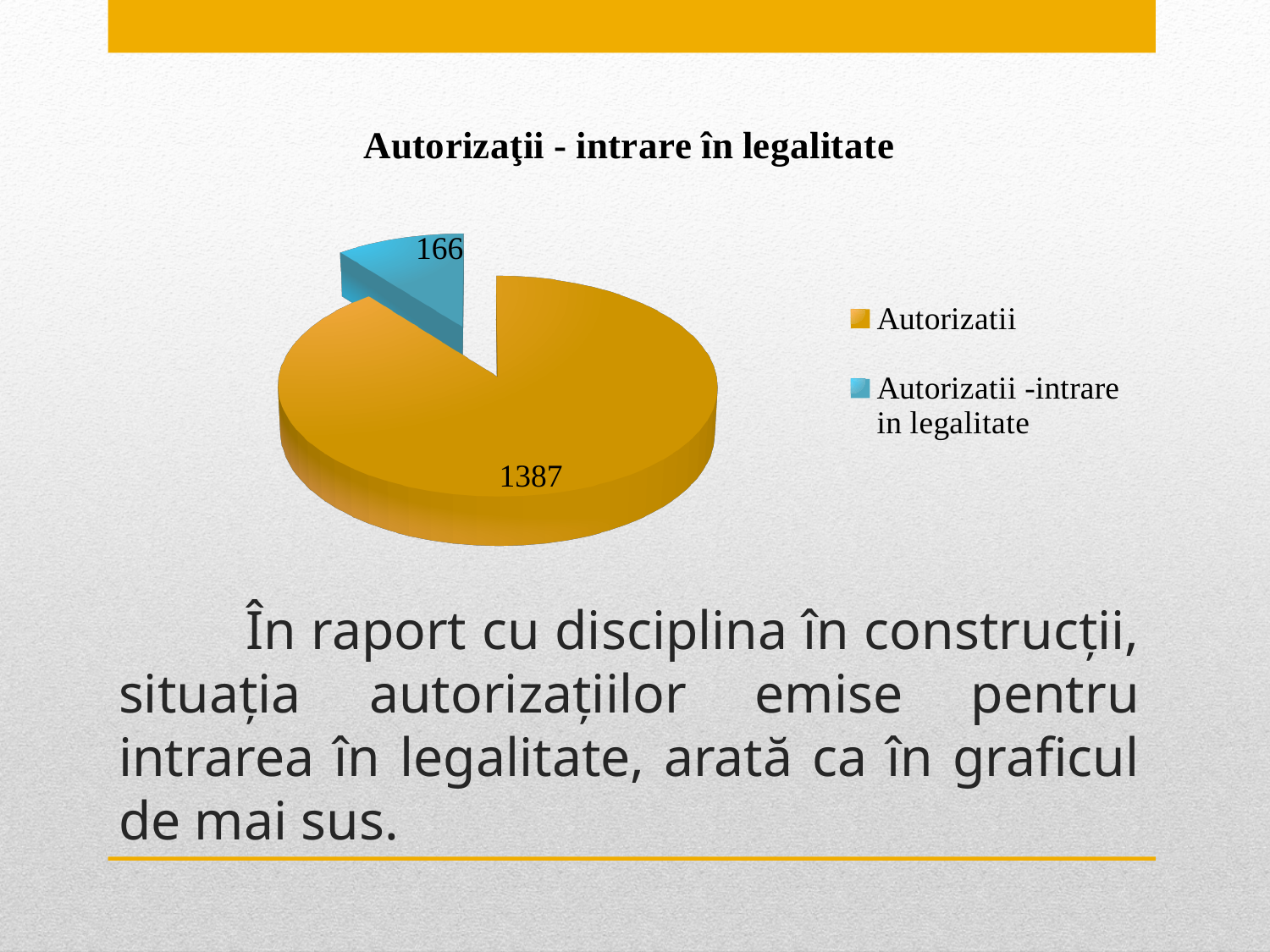
What is the total of the two slices in the pie chart? 1553 What colour is the Autorizatii -intrare in legalitate slice? blue Which slice is the largest in the pie chart? Autorizatii What is the value for the Autorizatii -intrare in legalitate slice? 166 What type of chart is shown on the slide? pie chart What is the title of the chart? Autorizaţii - intrare în legalitate What is the value for the Autorizatii slice? 1387 Which is larger: Autorizatii or Autorizatii -intrare in legalitate? Autorizatii How many entries does the legend list? 2 What is the difference between the Autorizatii value and the Autorizatii -intrare in legalitate value? 1221 How many slices does the pie chart have? 2 Which slice is the smallest in the pie chart? Autorizatii -intrare in legalitate